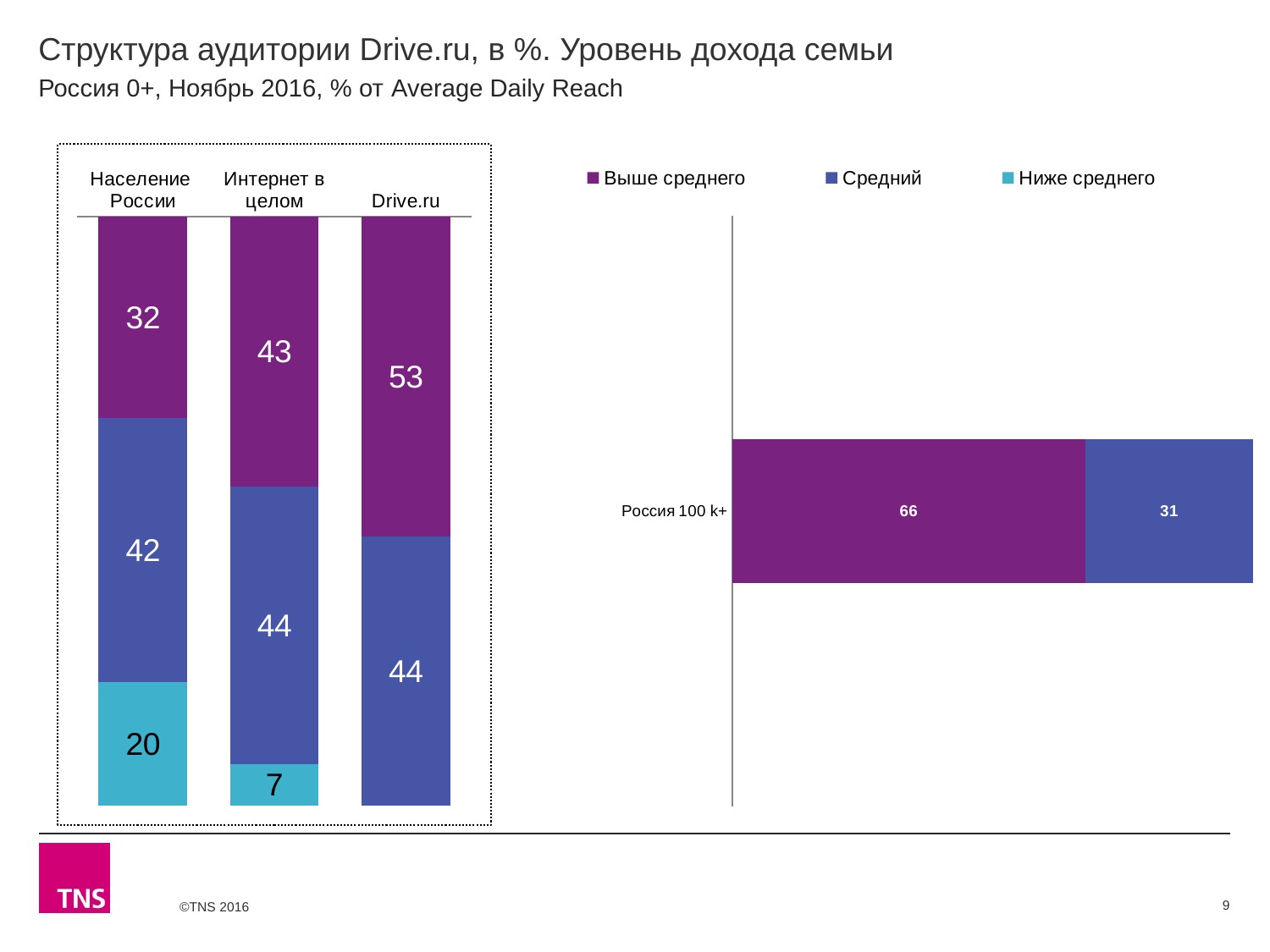
What type of chart is the right chart? Stacked bar chart In the left chart, which category has the lowest 'Ниже среднего' value among those with a printed label? Интернет в целом In the left chart, what is the value of the 'Ниже среднего' segment for 'Население России'? 20 In the left chart, which category has the highest 'Выше среднего' value? Drive.ru In the left chart, what is the difference between the 'Выше среднего' values for Drive.ru and 'Население России'? 21 How many series does the legend list? 3 In the left chart, how many categories are shown on the x axis? 3 In the left chart, what is the value of the 'Выше среднего' segment for Drive.ru? 53 In the right chart, what is the value of the 'Выше среднего' segment for 'Россия 100 k+'? 66 In the left chart, which is larger: the 'Ниже среднего' value for 'Население России' or for 'Интернет в целом'? Население России In the right chart, what is the value of the 'Средний' segment for 'Россия 100 k+'? 31 In the left chart, what is the value of the 'Средний' segment for 'Интернет в целом'? 44